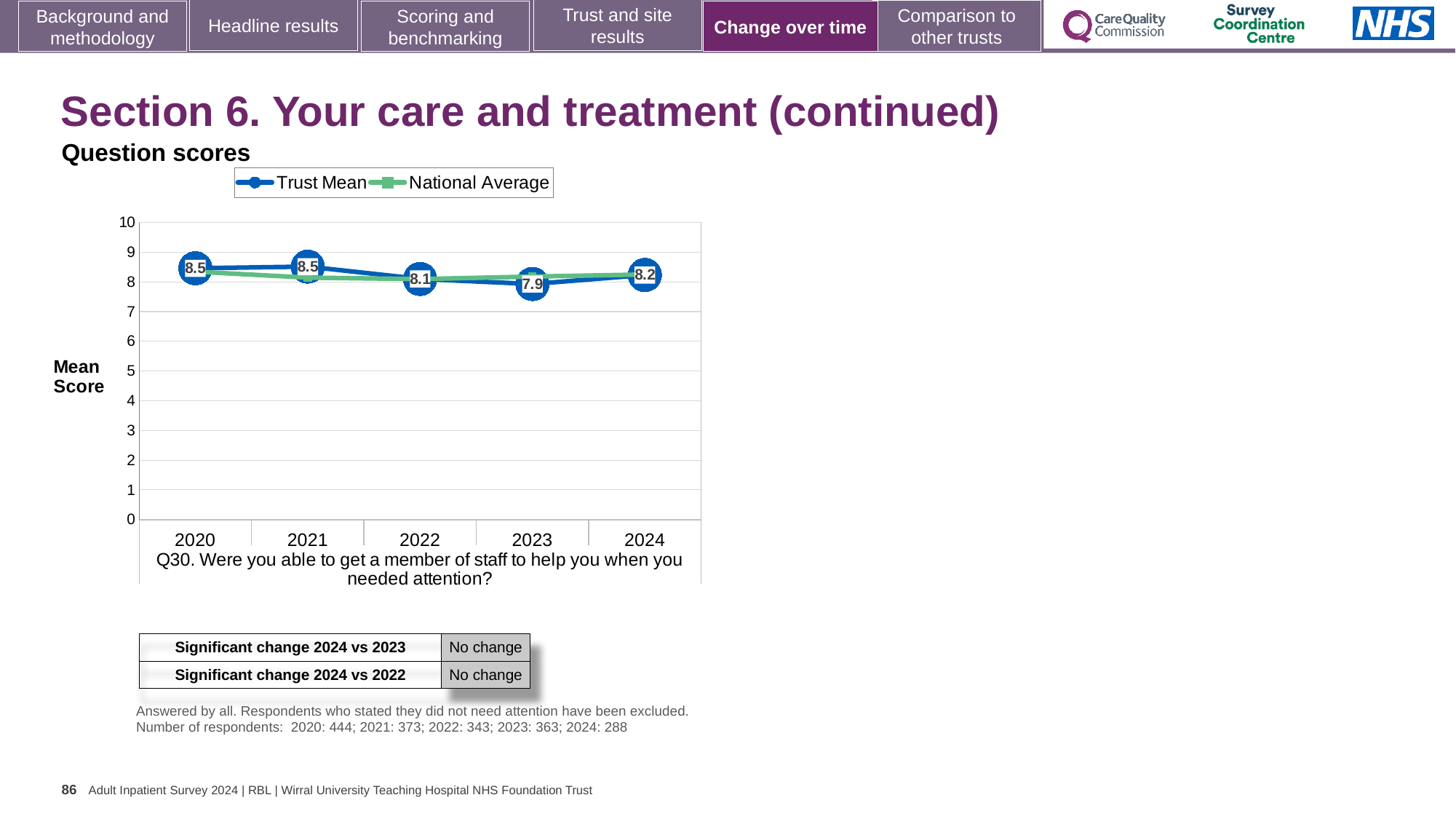
What kind of chart is shown? Line chart What is the Trust Mean score for 2024? 8.2 How many series does the legend list? 2 Which is larger, the Trust Mean score for 2020 or for 2024? 2020 What is the Trust Mean score for 2022? 8.1 Is the National Average value for 2020 greater or less than 5? greater What is the difference between the Trust Mean score in 2021 and in 2023? 0.6 What is the Trust Mean score for 2020? 8.5 How many years are plotted on the x axis? 5 In which year is the Trust Mean score lowest? 2023 Does the Trust Mean score rise or fall from 2021 to 2023? Fall What is the Trust Mean score for 2023? 7.9